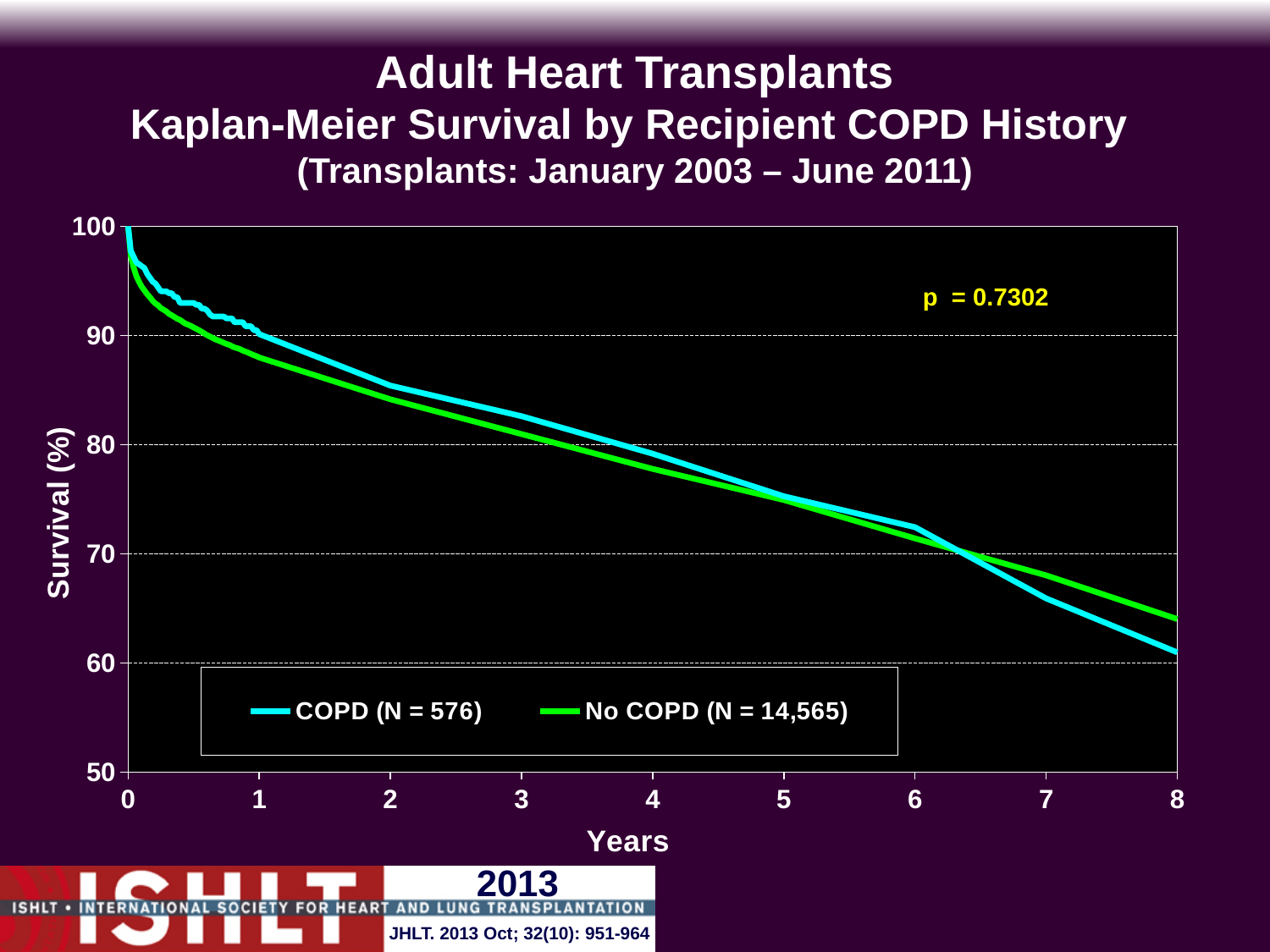
What is the N for the No COPD group in the legend? 14,565 Is the survival value for COPD at 2 years greater or less than 80? greater How many series does the legend list? 2 What p-value is shown on the chart? p = 0.7302 At 8 years, which group has the higher survival, COPD or No COPD? No COPD Is the survival value for No COPD at 8 years greater or less than 60? greater Do the survival curves rise or fall as years increase? fall At 1 year, which group has the higher survival, COPD or No COPD? COPD Is the survival value for COPD at 7 years greater or less than 70? less How many tick marks are labelled on the Years axis? 9 What kind of chart is shown on the slide? line chart